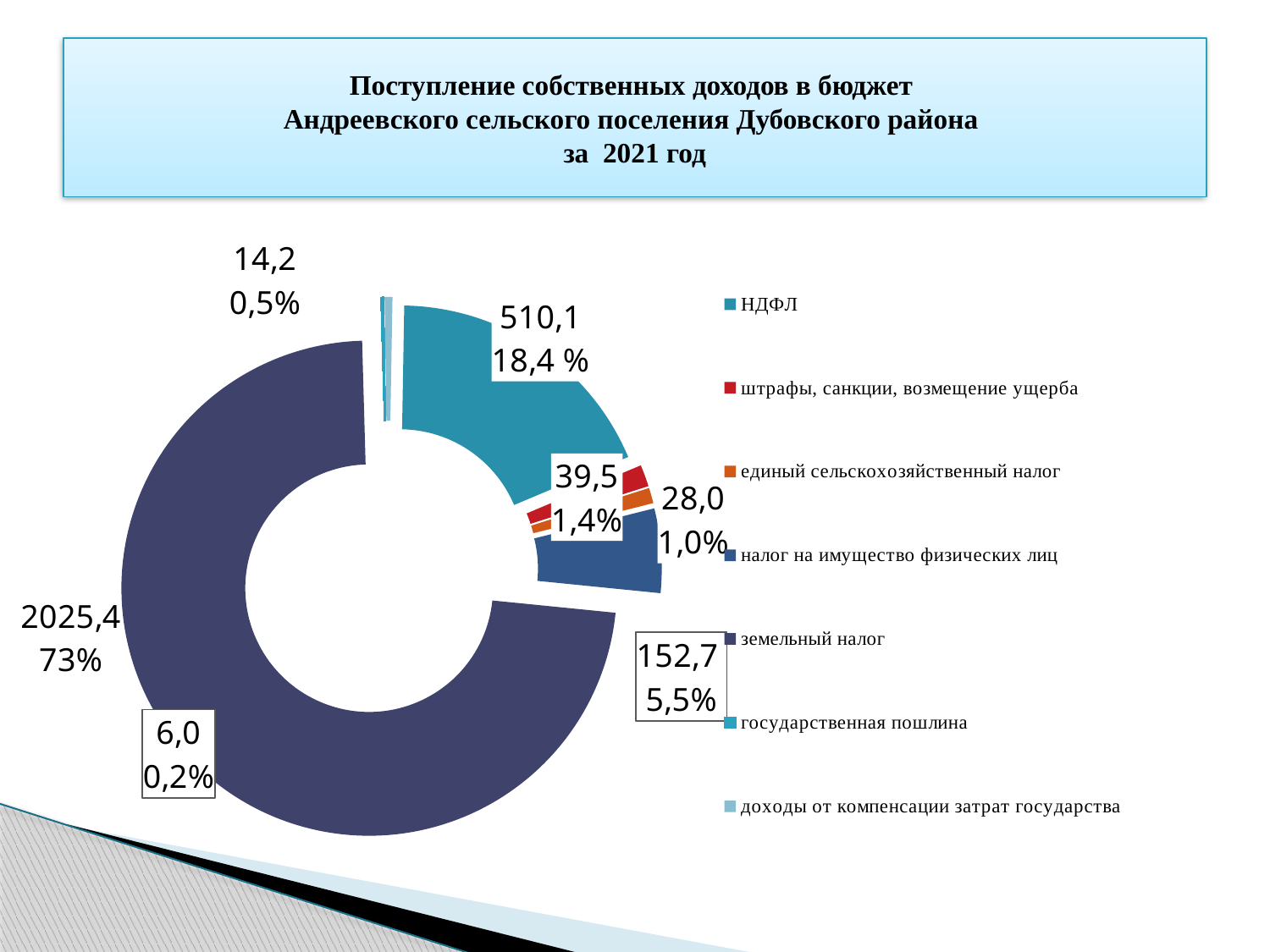
Which is larger: штрафы, санкции, возмещение ущерба or единый сельскохозяйственный налог? штрафы, санкции, возмещение ущерба Which category has the largest slice of the chart? земельный налог What share of the total does земельный налог make up? 73% What is the value shown for НДФЛ? 510,1 What is the difference between the values for НДФЛ and налог на имущество физических лиц? 357,4 For which year does the chart show the budget revenues? 2021 Which category has the smallest slice of the chart? государственная пошлина What percentage share is shown for НДФЛ? 18,4 % What is the value shown for земельный налог? 2025,4 What kind of chart is shown on the slide? Doughnut (pie) chart What is the value shown for налог на имущество физических лиц? 152,7 How many categories does the legend of the chart list? 7